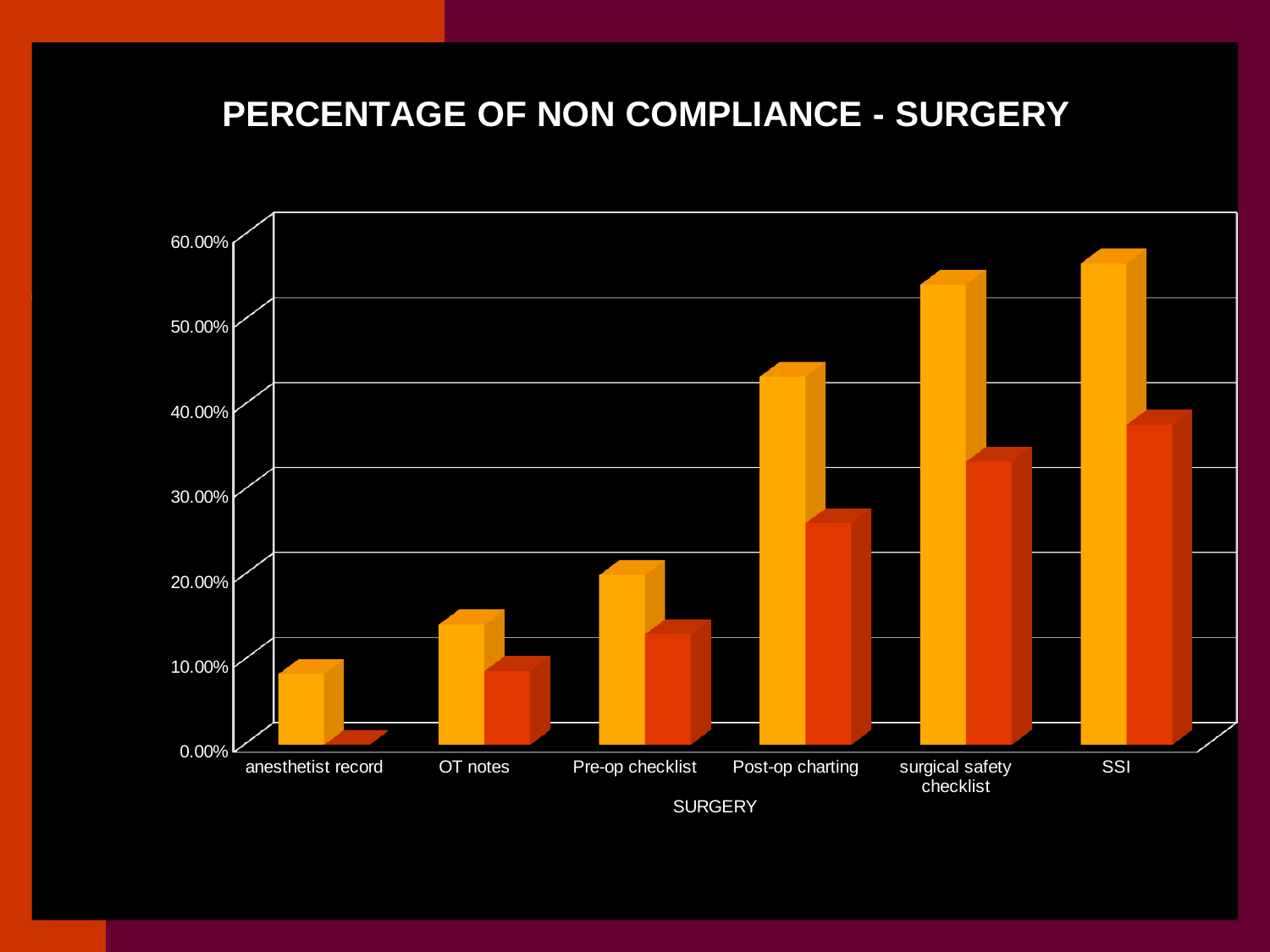
What kind of chart is shown on the slide? bar chart Which category has the highest orange bar? SSI Is the yellow bar for surgical safety checklist greater or less than 50.00%? greater What is the label on the x axis of the chart? SURGERY Is the orange bar for Post-op charting greater or less than 30.00%? less What is the title of the chart? PERCENTAGE OF NON COMPLIANCE - SURGERY Is the yellow bar for Post-op charting greater or less than 40.00%? greater How many categories are shown on the x axis of the chart? 6 Do the yellow bars generally rise or fall from left to right across the categories? rise Which category has the lowest yellow bar? anesthetist record For Post-op charting, which bar is taller, the yellow bar or the orange bar? the yellow bar Which category has the highest yellow bar? SSI